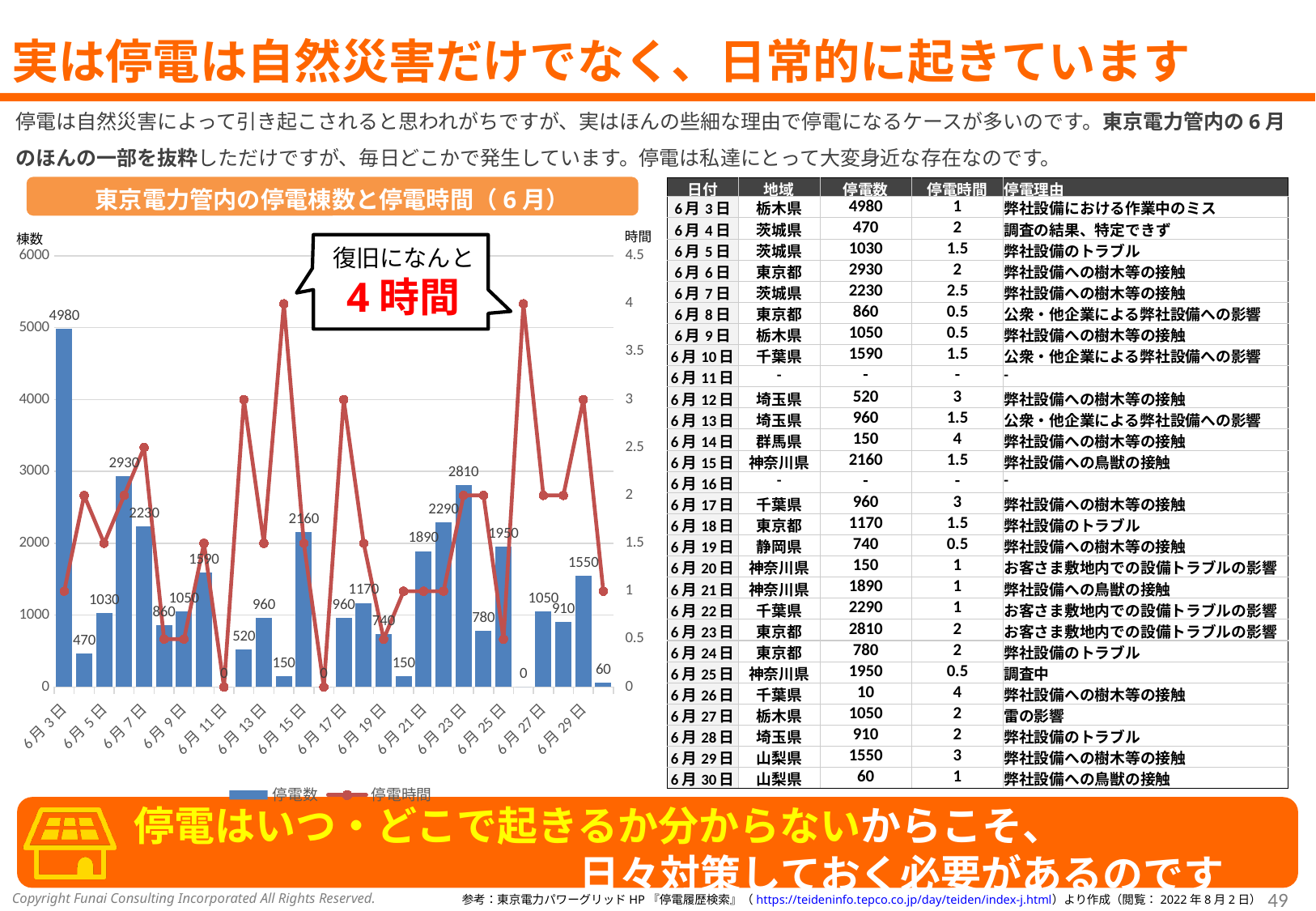
What kind of chart is shown on the left of the slide? Combined bar and line chart Which date has the highest 停電数 bar in the chart? 6月3日 Is the 停電時間 value for 6月14日 greater or less than 3? greater Which has the larger 停電数 bar, 6月15日 or 6月22日? 6月22日 What is the 停電時間 value for 6月26日 in the chart? 4 What is the 停電数 value for 6月29日 in the chart? 1550 What is the 停電数 value for 6月3日 in the chart? 4980 What does the callout box above the chart say the recovery took? 4時間 What is the difference in 停電数 between 6月6日 and 6月7日? 700 What is the title of the chart on the left of the slide? 東京電力管内の停電棟数と停電時間（6月） What is the 停電数 value for 6月23日 in the chart? 2810 How many series does the chart legend list? 2